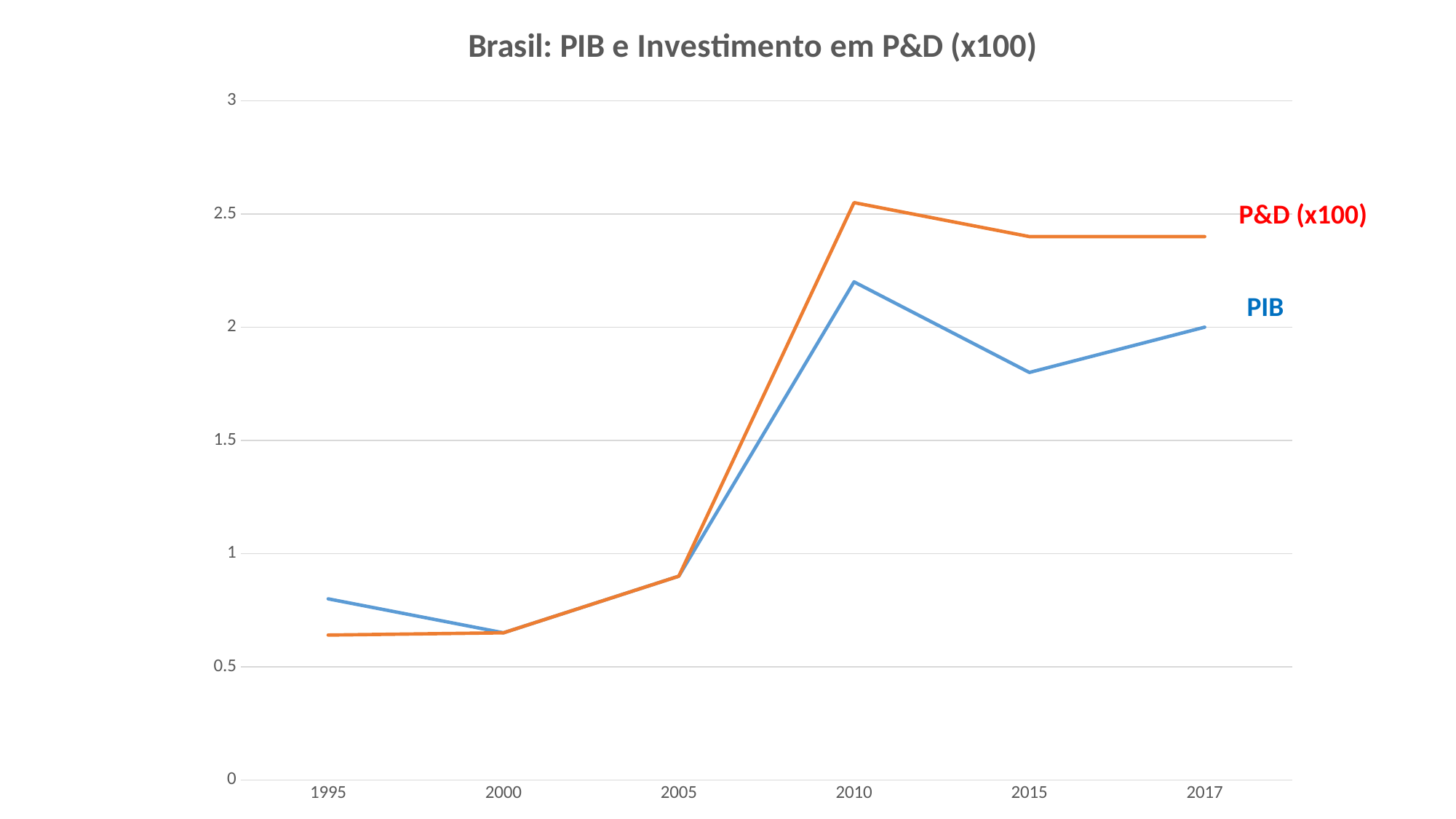
In which year is the PIB series at its lowest value? 2000 How many years are shown on the x axis? 6 In 2010, which series has the higher value, PIB or P&D (x100)? P&D (x100) What is the title of the chart? Brasil: PIB e Investimento em P&D (x100) In which year does the P&D (x100) series reach its highest value? 2010 Is the value of P&D (x100) in 2015 greater or less than 2.5? less Is the value of P&D (x100) in 2010 greater or less than 2? greater In 1995, which series has the higher value, PIB or P&D (x100)? PIB Is the value of PIB in 2015 greater or less than 2? less What kind of chart is shown on the slide? line chart Does the PIB series rise or fall between 2010 and 2015? fall How many series are plotted in the chart? 2